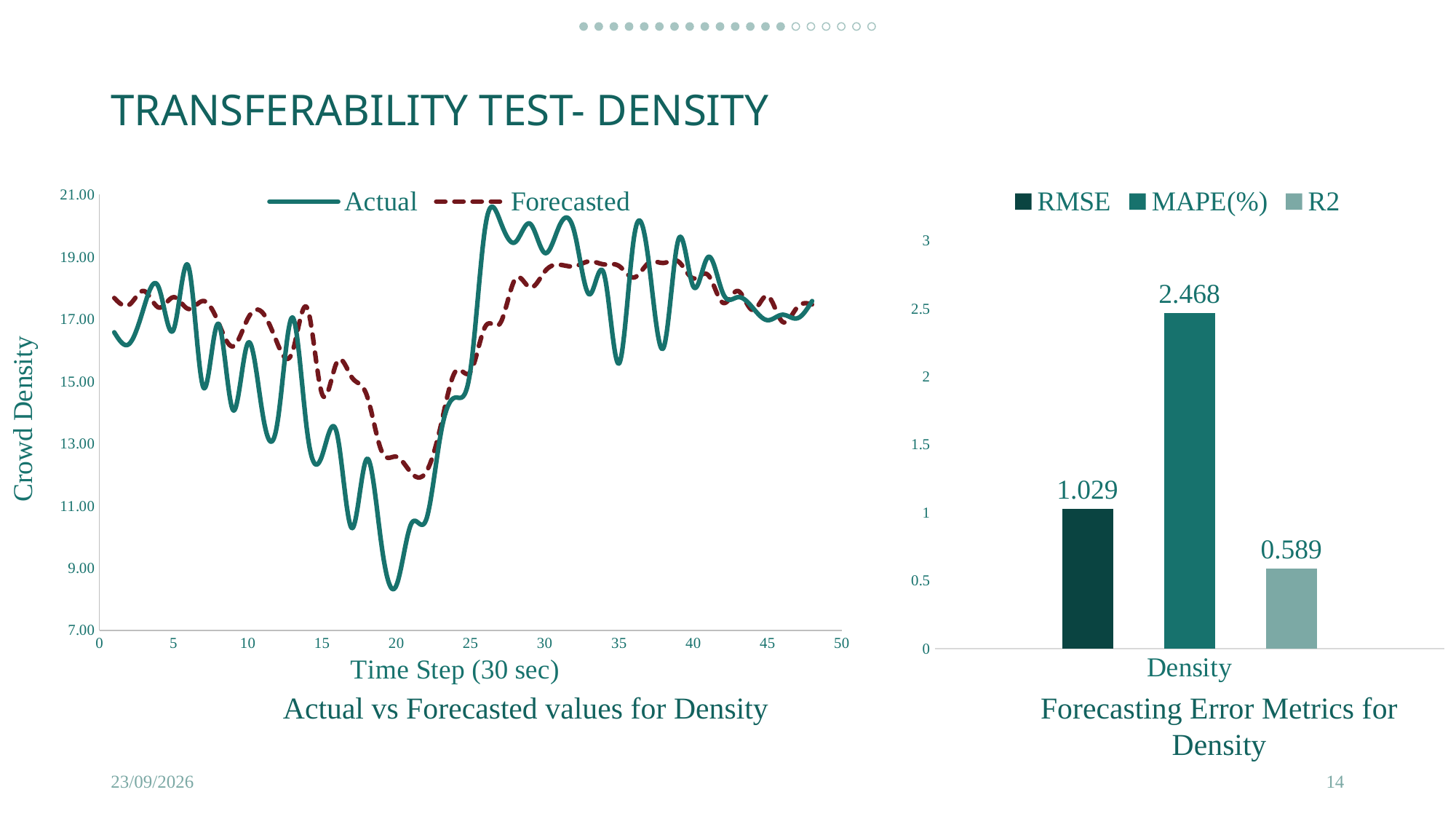
How many series does the legend of the 'Forecasting Error Metrics for Density' chart list? 3 In the 'Forecasting Error Metrics for Density' chart, which metric has the highest value? MAPE(%) In the 'Actual vs Forecasted values for Density' chart, is the Actual value at time step 20 greater or less than 11.00? less How many series does the legend of the 'Actual vs Forecasted values for Density' chart list? 2 What kind of chart is the 'Forecasting Error Metrics for Density' chart? Bar chart In the 'Forecasting Error Metrics for Density' chart, what is the value of R2? 0.589 In the 'Forecasting Error Metrics for Density' chart, which metric has the lowest value? R2 In the 'Forecasting Error Metrics for Density' chart, what is the value of MAPE(%)? 2.468 What kind of chart is the 'Actual vs Forecasted values for Density' chart? Line chart In the 'Forecasting Error Metrics for Density' chart, which is larger, RMSE or R2? RMSE In the 'Forecasting Error Metrics for Density' chart, what is the value of RMSE? 1.029 In the 'Forecasting Error Metrics for Density' chart, what is the difference between the MAPE(%) value and the RMSE value? 1.439